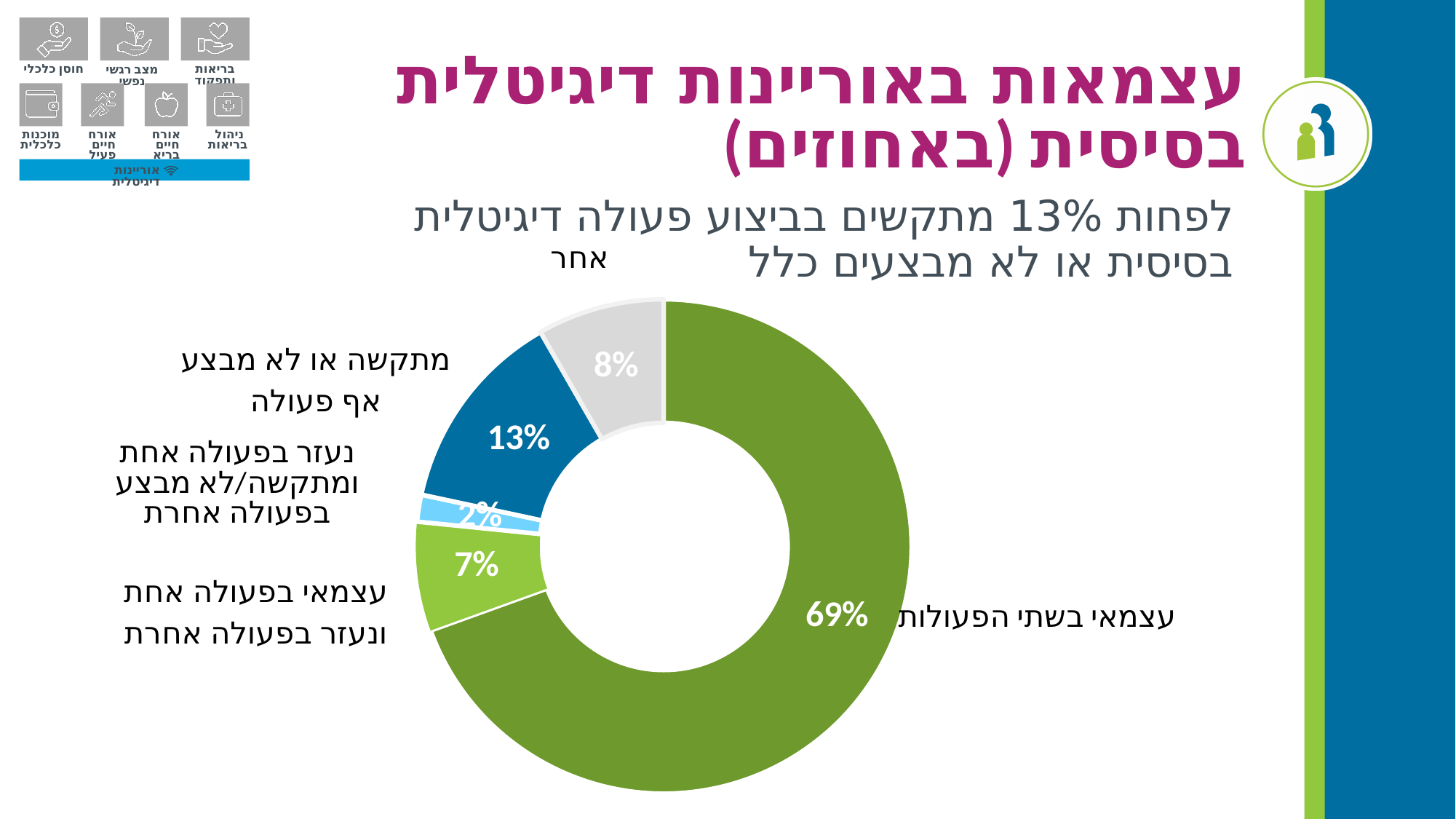
What percentage is shown for "עצמאי בפעולה אחת ונעזר בפעולה אחרת"? 7% What is the difference in percentage points between "עצמאי בשתי הפעולות" and "מתקשה או לא מבצע אף פעולה"? 56 Which is larger: the slice for "מתקשה או לא מבצע אף פעולה" or the slice for "אחר"? מתקשה או לא מבצע אף פעולה What percentage is shown for "נעזר בפעולה אחת ומתקשה/לא מבצע בפעולה אחרת"? 2% What percentage is shown for "מתקשה או לא מבצע אף פעולה"? 13% What colour is the slice labelled "אחר"? Grey Which category has the smallest slice in the donut chart? נעזר בפעולה אחת ומתקשה/לא מבצע בפעולה אחרת Which category has the largest slice in the donut chart? עצמאי בשתי הפעולות What percentage is shown for the slice labelled "אחר"? 8% What share of the donut chart is labelled "עצמאי בשתי הפעולות"? 69% What kind of chart is shown on the slide? Donut (pie) chart How many slices does the donut chart have? 5